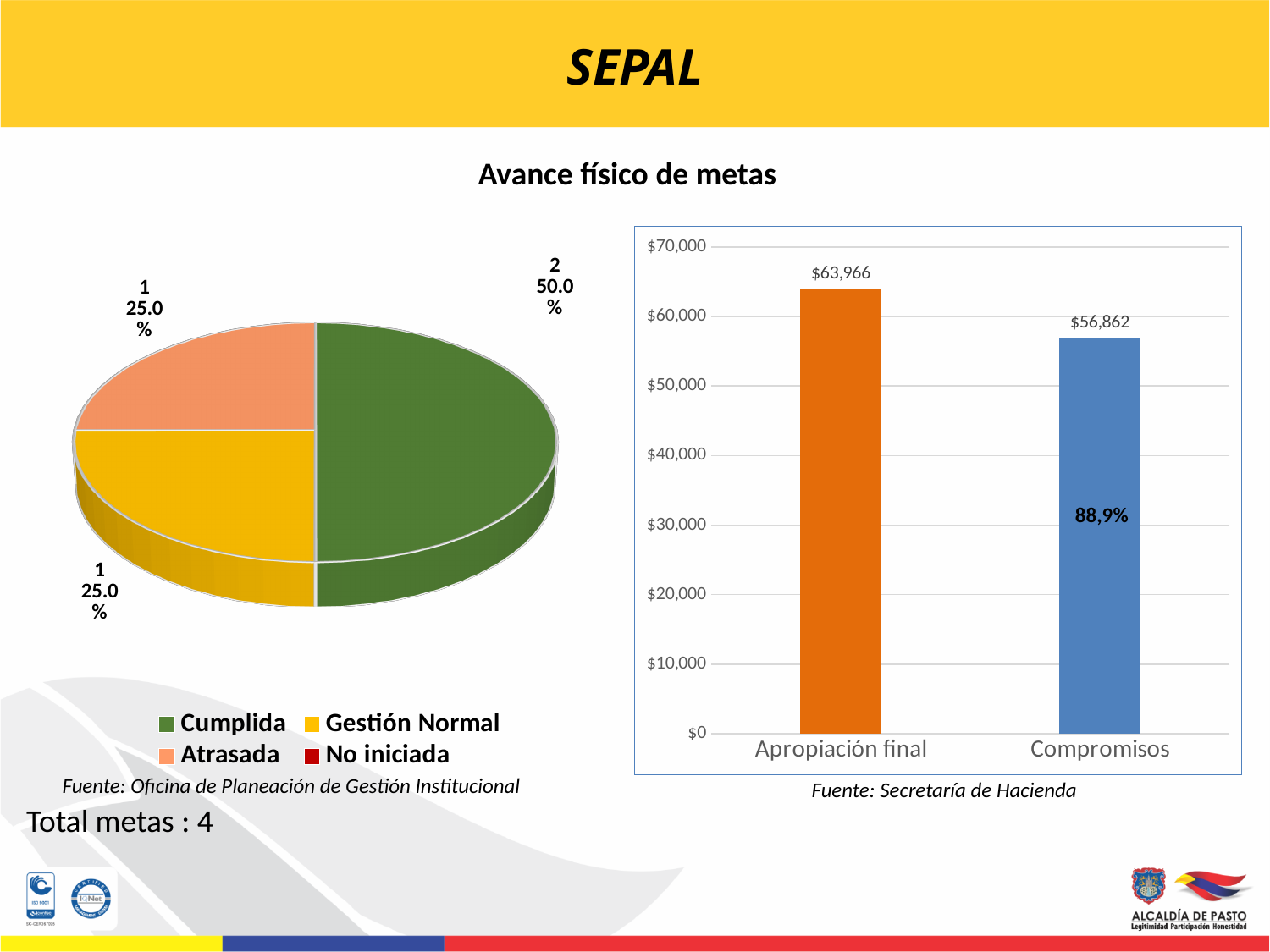
On the pie chart on the left, what colour is the Gestión Normal slice? Yellow What kind of chart is the chart on the left of the slide? Pie chart On the pie chart on the left, what share of the pie does the Cumplida slice represent? 50.0% On the bar chart on the right, how many categories are shown on the x axis? 2 On the pie chart on the left, how many metas are in the Atrasada category? 1 What kind of chart is the chart on the right of the slide? Bar chart On the bar chart on the right, what is the value for Compromisos? $56,862 On the bar chart on the right, which category has the higher value, Apropiación final or Compromisos? Apropiación final On the pie chart on the left, which category has the largest slice? Cumplida On the bar chart on the right, what is the value for Apropiación final? $63,966 On the pie chart on the left, how many entries does the legend list? 4 On the bar chart on the right, what is the difference between Apropiación final and Compromisos? $7,104